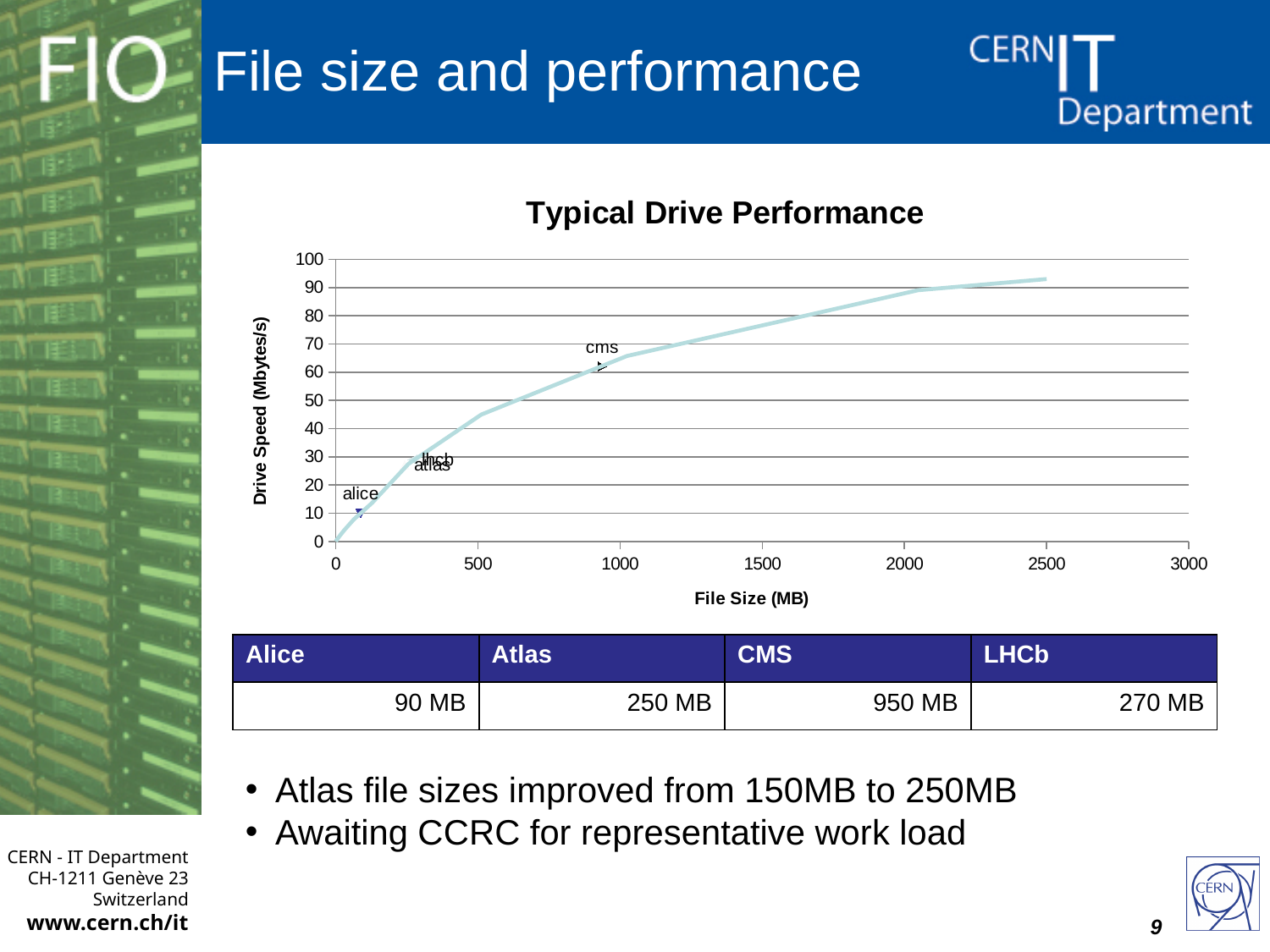
Which has the higher drive speed on the chart, cms or atlas? cms Which labelled experiment has the highest drive speed on the chart? cms Is the drive speed at a file size of 2500 MB greater or less than 80 Mbytes/s? greater Which labelled experiment has the lowest drive speed on the chart? alice What is the label of the x axis of the chart? File Size (MB) Is the drive speed for alice greater or less than 20 Mbytes/s? less What is the title of the chart? Typical Drive Performance How many experiments are labelled as points on the chart? 4 Is the drive speed for cms greater or less than 50 Mbytes/s? greater Does the drive speed rise or fall as file size increases along the x axis? rises What kind of chart is shown on the slide? line chart